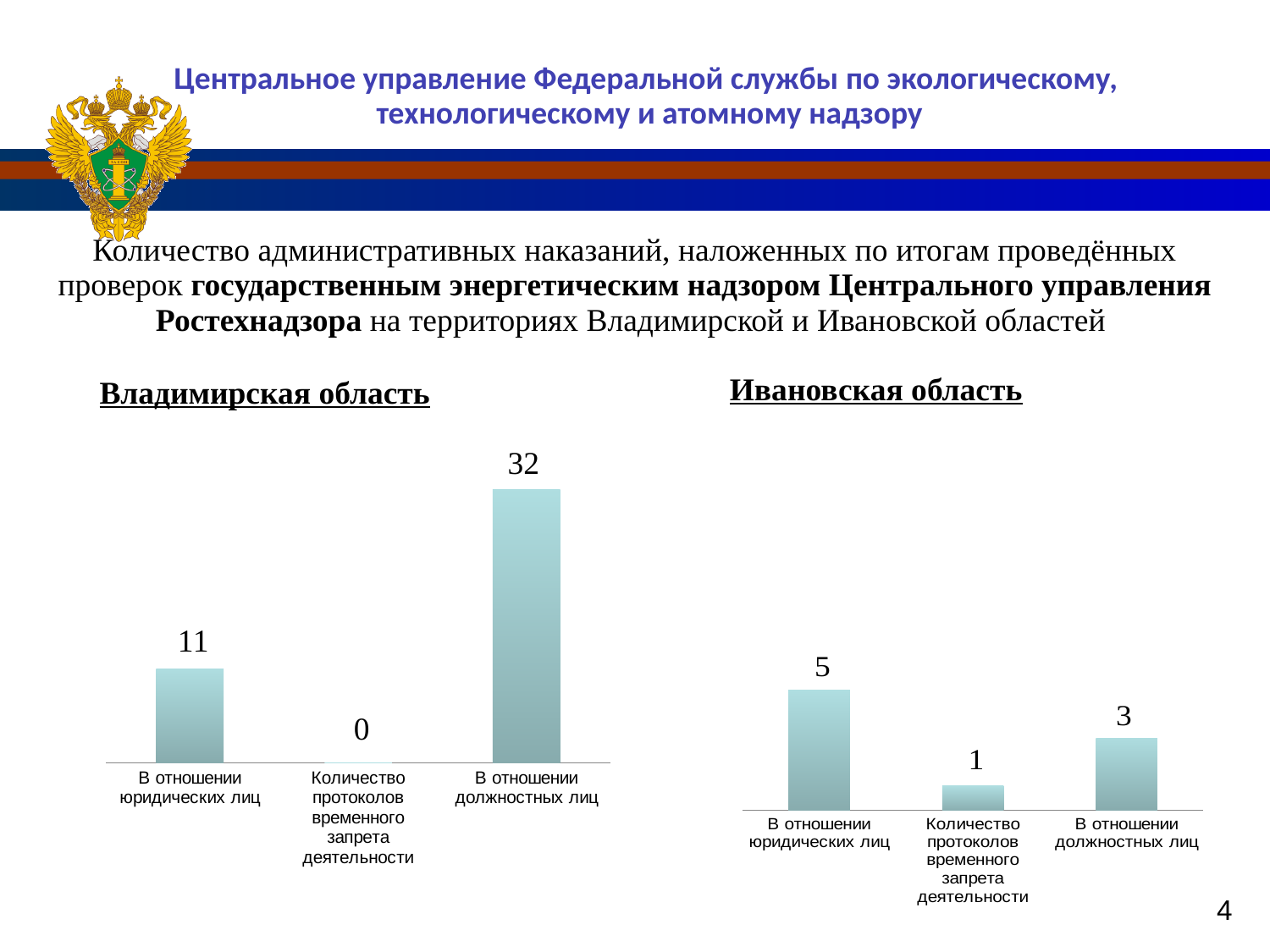
In the Ивановская область chart, which category has the highest value? В отношении юридических лиц In the Владимирская область chart, what is the value for В отношении должностных лиц? 32 How many categories does the Ивановская область chart show? 3 In the Владимирская область chart, which category has the lowest value? Количество протоколов временного запрета деятельности What type of chart is the Владимирская область chart? bar chart In the Ивановская область chart, what is the value for В отношении должностных лиц? 3 In the Ивановская область chart, what is the difference between В отношении юридических лиц and Количество протоколов временного запрета деятельности? 4 In the Владимирская область chart, what is the difference between В отношении должностных лиц and В отношении юридических лиц? 21 In the Владимирская область chart, what is the value for В отношении юридических лиц? 11 In the Владимирская область chart, what is the value for Количество протоколов временного запрета деятельности? 0 Which is larger: В отношении должностных лиц in the Владимирская область chart or В отношении должностных лиц in the Ивановская область chart? Владимирская область In the Ивановская область chart, what is the value for В отношении юридических лиц? 5